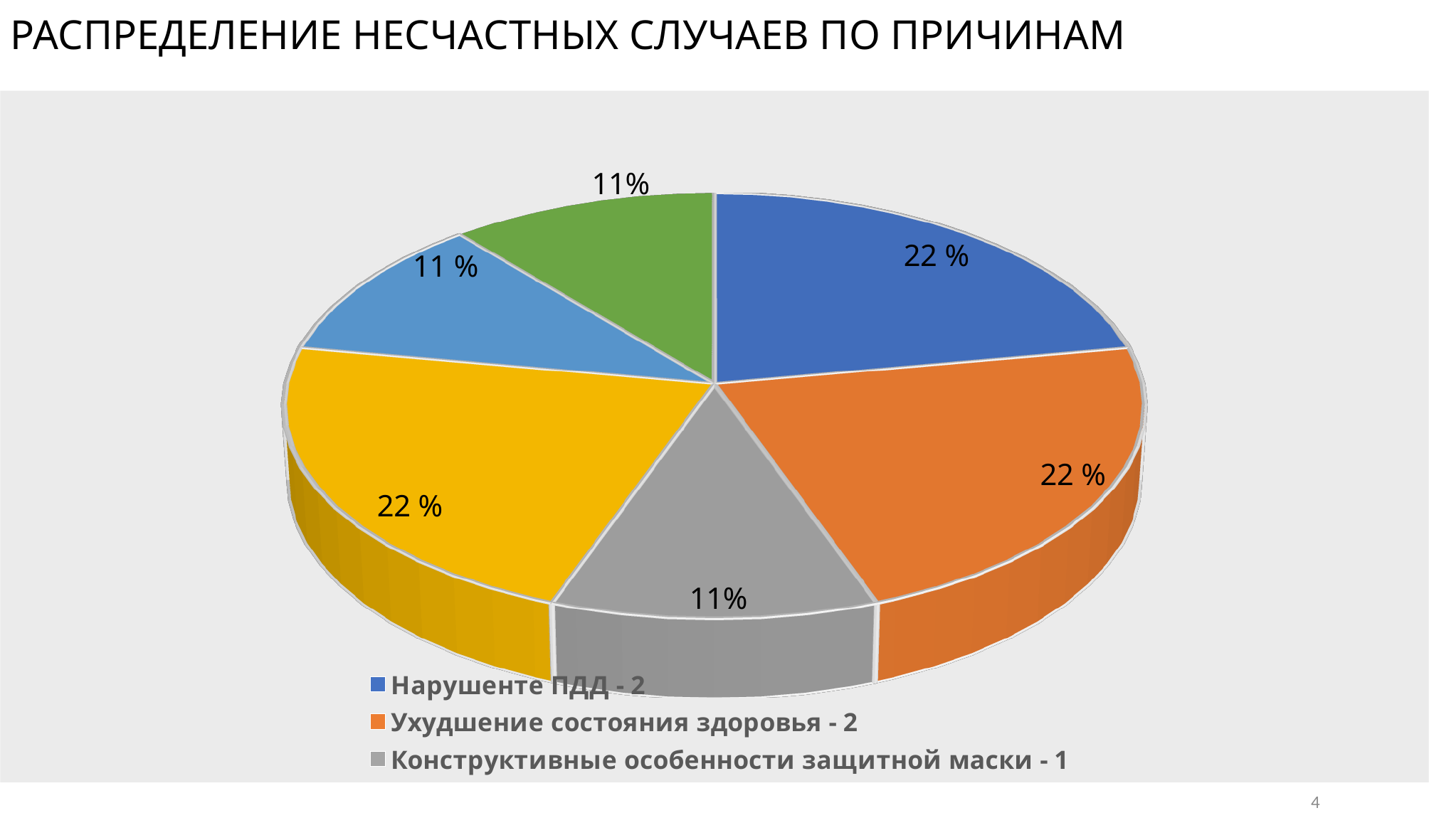
How many slices in the pie chart are labelled with 22 %? 3 How many entries does the legend list? 3 What share of the pie does the slice for "Нарушенте ПДД - 2" have? 22 % What share of the pie does the slice for "Ухудшение состояния здоровья - 2" have? 22 % What kind of chart is shown on the slide? pie chart What is the difference in percentage points between the slice for "Ухудшение состояния здоровья - 2" and the slice for "Конструктивные особенности защитной маски - 1"? 11 What colour is the slice for "Конструктивные особенности защитной маски - 1"? gray What is the title of the slide? РАСПРЕДЕЛЕНИЕ НЕСЧАСТНЫХ СЛУЧАЕВ ПО ПРИЧИНАМ What share of the pie does the slice for "Конструктивные особенности защитной маски - 1" have? 11% How many slices does the pie chart have? 6 Which is larger, the slice for "Нарушенте ПДД - 2" or the slice for "Конструктивные особенности защитной маски - 1"? Нарушенте ПДД - 2